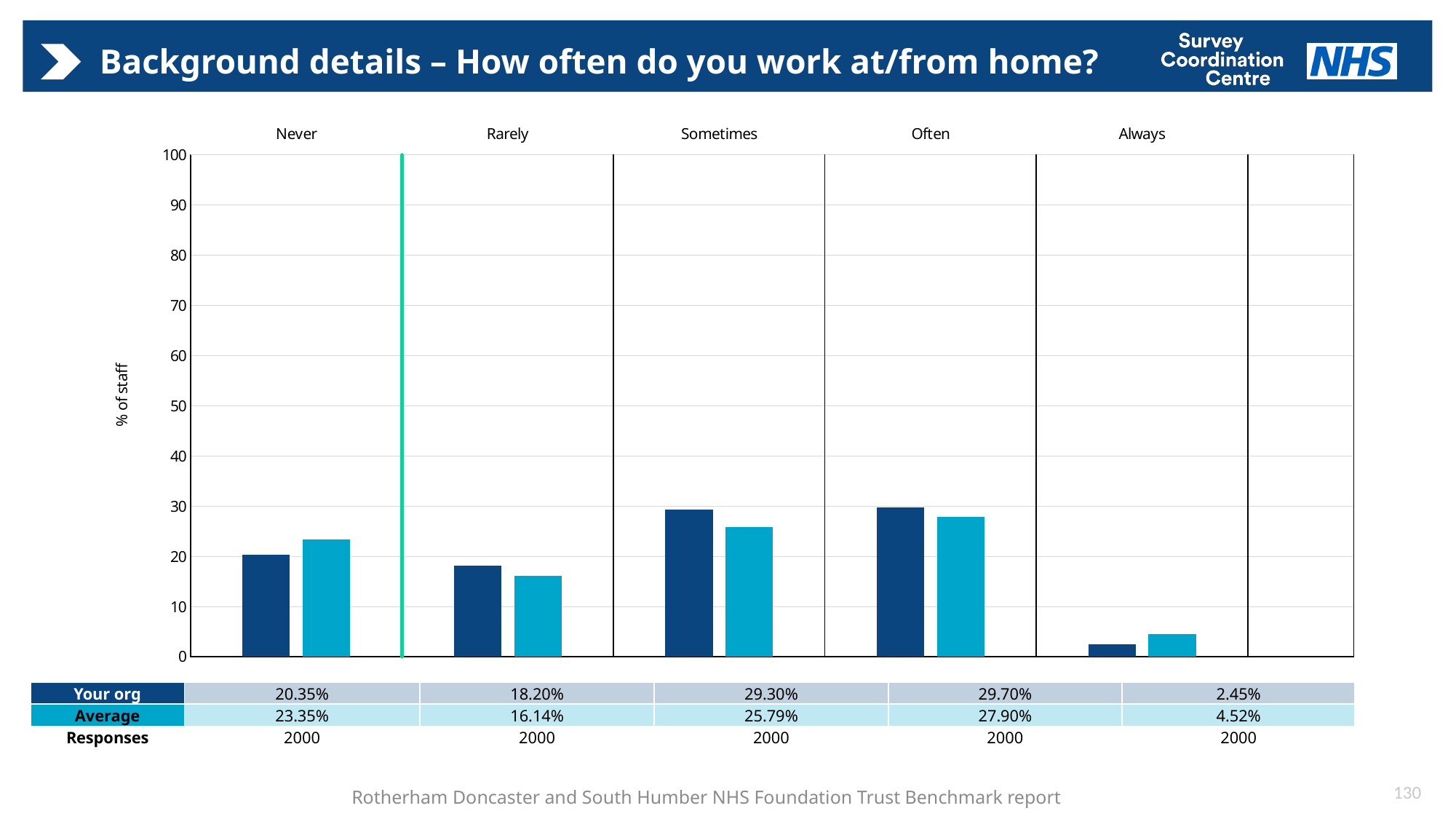
What is the Average value for Always? 4.52% What is the Your org value for Sometimes? 29.30% Which is larger for Rarely, the Your org value or the Average value? Your org What is the Your org value for Never? 20.35% What is the label on the y axis of the chart? % of staff How many series does the chart show? 2 What kind of chart is shown on the slide? bar chart Is the Your org value for Often greater or less than 20? greater How many response categories are shown on the chart? 5 What is the difference between the Average and Your org values for Never? 3.00 percentage points Which category has the highest Average value? Often Which category has the lowest Your org value? Always